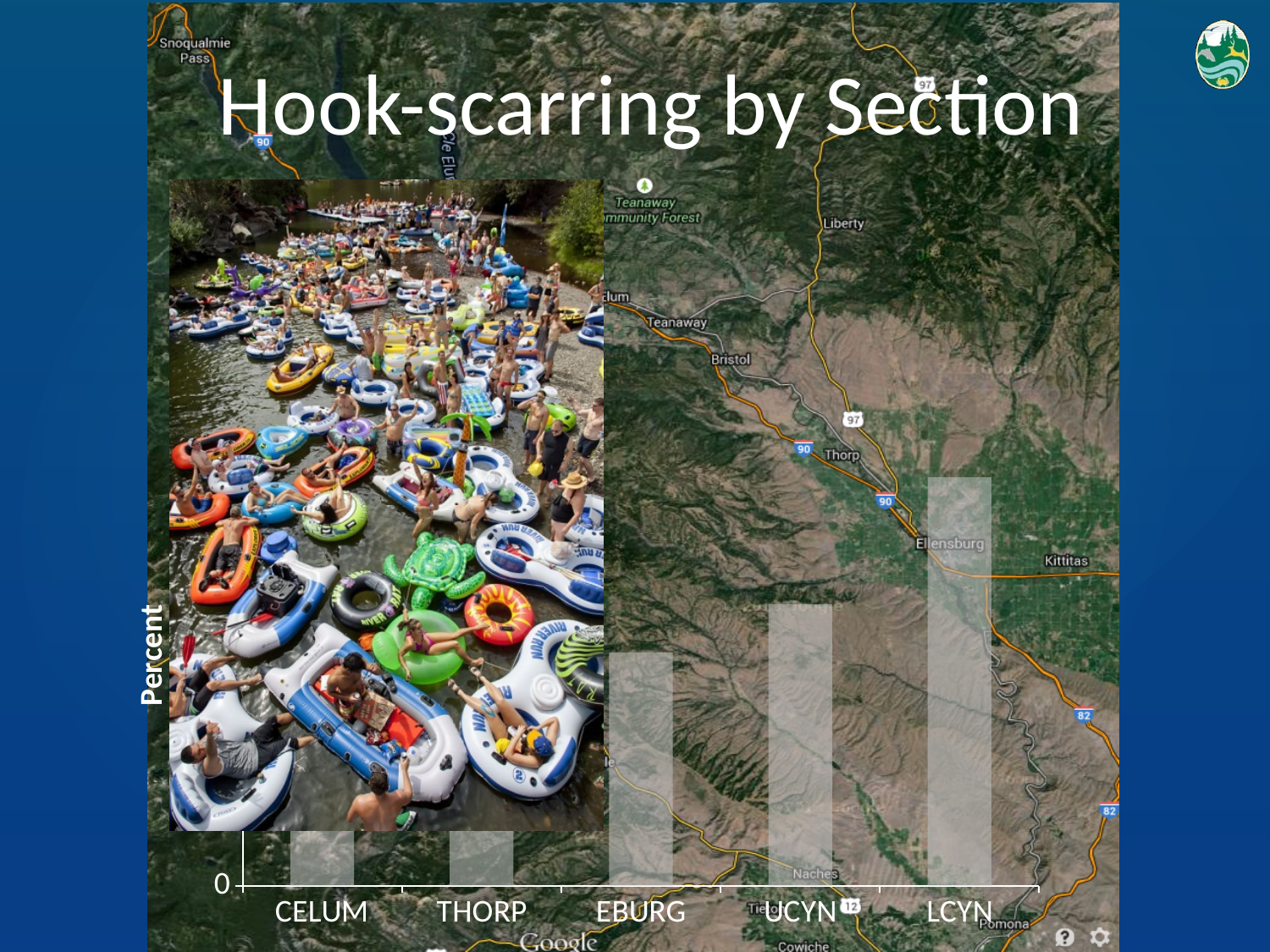
How many sections (categories) are shown on the x axis of the chart? 5 What is the title of the chart? Hook-scarring by Section What is the label on the vertical axis of the chart? Percent What kind of chart is shown on the slide? bar chart Which section has the highest hook-scarring percentage? LCYN Which section is listed first on the x axis? CELUM Is the value for LCYN larger or smaller than the value for EBURG? larger